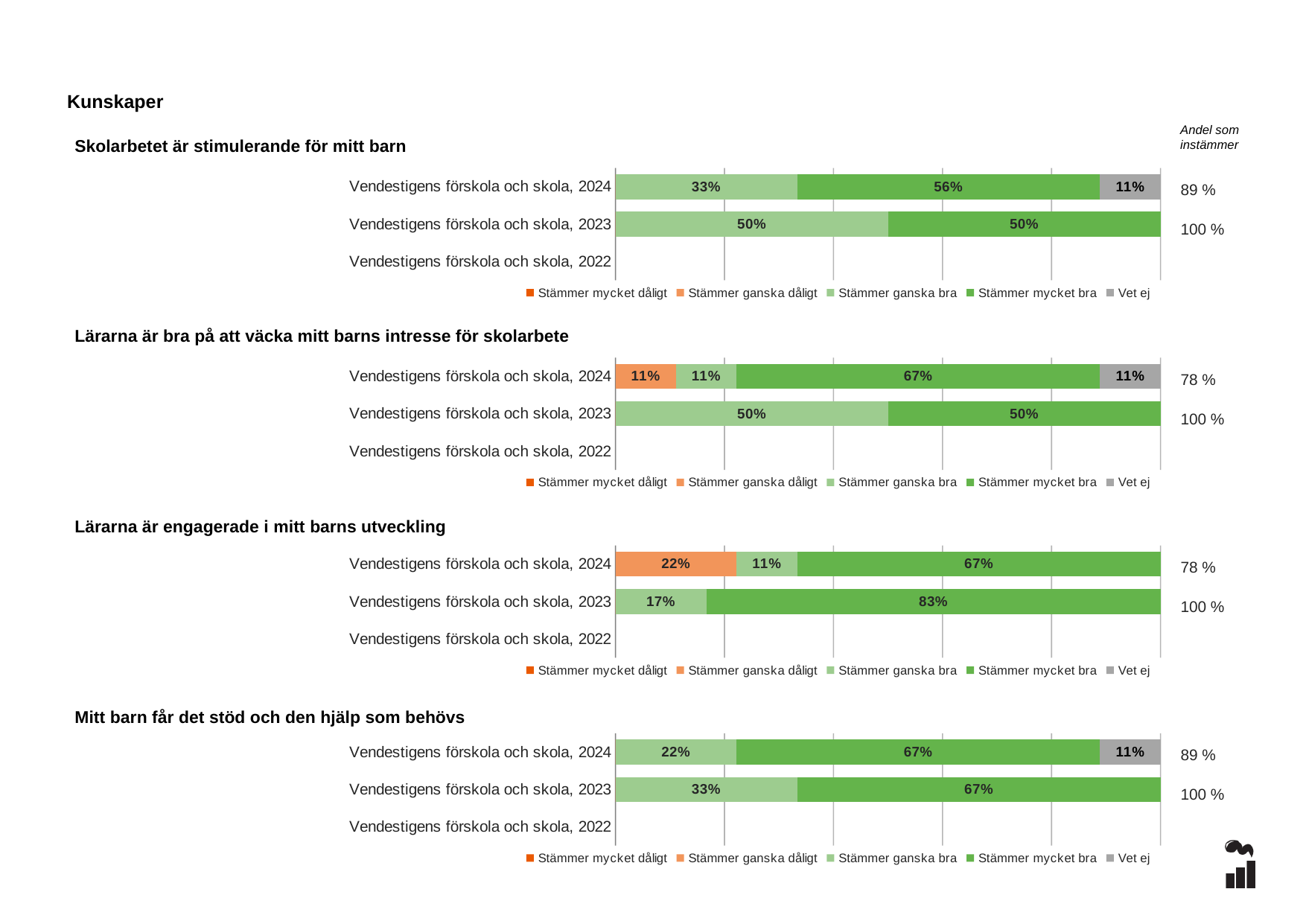
In the chart 'Lärarna är engagerade i mitt barns utveckling', which segment is largest in the 2024 bar? Stämmer mycket bra In the chart 'Lärarna är bra på att väcka mitt barns intresse för skolarbete', what is the 'Andel som instämmer' value for Vendestigens förskola och skola, 2023? 100 % In the chart 'Mitt barn får det stöd och den hjälp som behövs', which is larger: 'Stämmer ganska bra' for 2024 or 'Stämmer mycket bra' for 2024? Stämmer mycket bra for 2024 How many series does the legend list in the chart 'Skolarbetet är stimulerande för mitt barn'? 5 In the chart 'Lärarna är bra på att väcka mitt barns intresse för skolarbete', what is the value for 'Stämmer ganska dåligt' for Vendestigens förskola och skola, 2024? 11% In the chart 'Skolarbetet är stimulerande för mitt barn', what is the 'Andel som instämmer' value for Vendestigens förskola och skola, 2024? 89 % What kind of chart is used for 'Mitt barn får det stöd och den hjälp som behövs'? Stacked bar chart How many categories (rows) are shown in the chart 'Lärarna är bra på att väcka mitt barns intresse för skolarbete'? 3 In the chart 'Lärarna är engagerade i mitt barns utveckling', what is the total of the 2024 stacked bar? 100% In the chart 'Lärarna är engagerade i mitt barns utveckling', what is the value for 'Stämmer mycket bra' for Vendestigens förskola och skola, 2023? 83% In the chart 'Skolarbetet är stimulerande för mitt barn', what is the value for 'Stämmer mycket bra' for Vendestigens förskola och skola, 2024? 56% In the chart 'Mitt barn får det stöd och den hjälp som behövs', what is the difference between the 'Stämmer ganska bra' values for 2023 and 2024? 11%